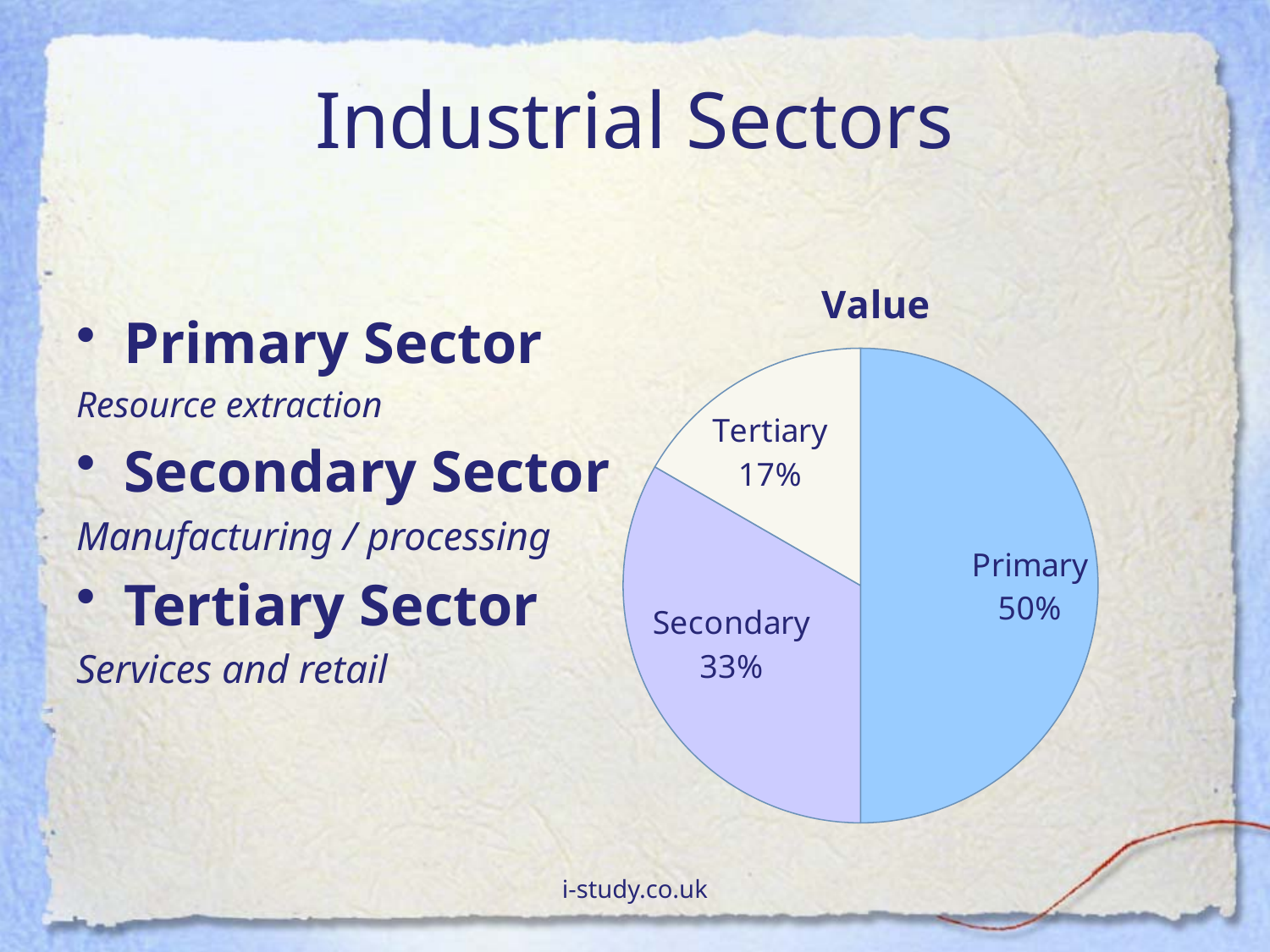
Which sector has the largest slice of the pie? Primary What is the difference in percentage points between the Secondary and Tertiary slices? 16 What share of the pie does the Secondary sector have? 33% What is the difference in percentage points between the Primary and Secondary slices? 17 What is the chart's title? Value Which is larger, the Secondary slice or the Tertiary slice? Secondary What colour is the Primary slice? light blue How many slices does the pie chart have? 3 What share of the pie does the Primary sector have? 50% What type of chart is shown on the slide? pie chart Which sector has the smallest slice of the pie? Tertiary What share of the pie does the Tertiary sector have? 17%